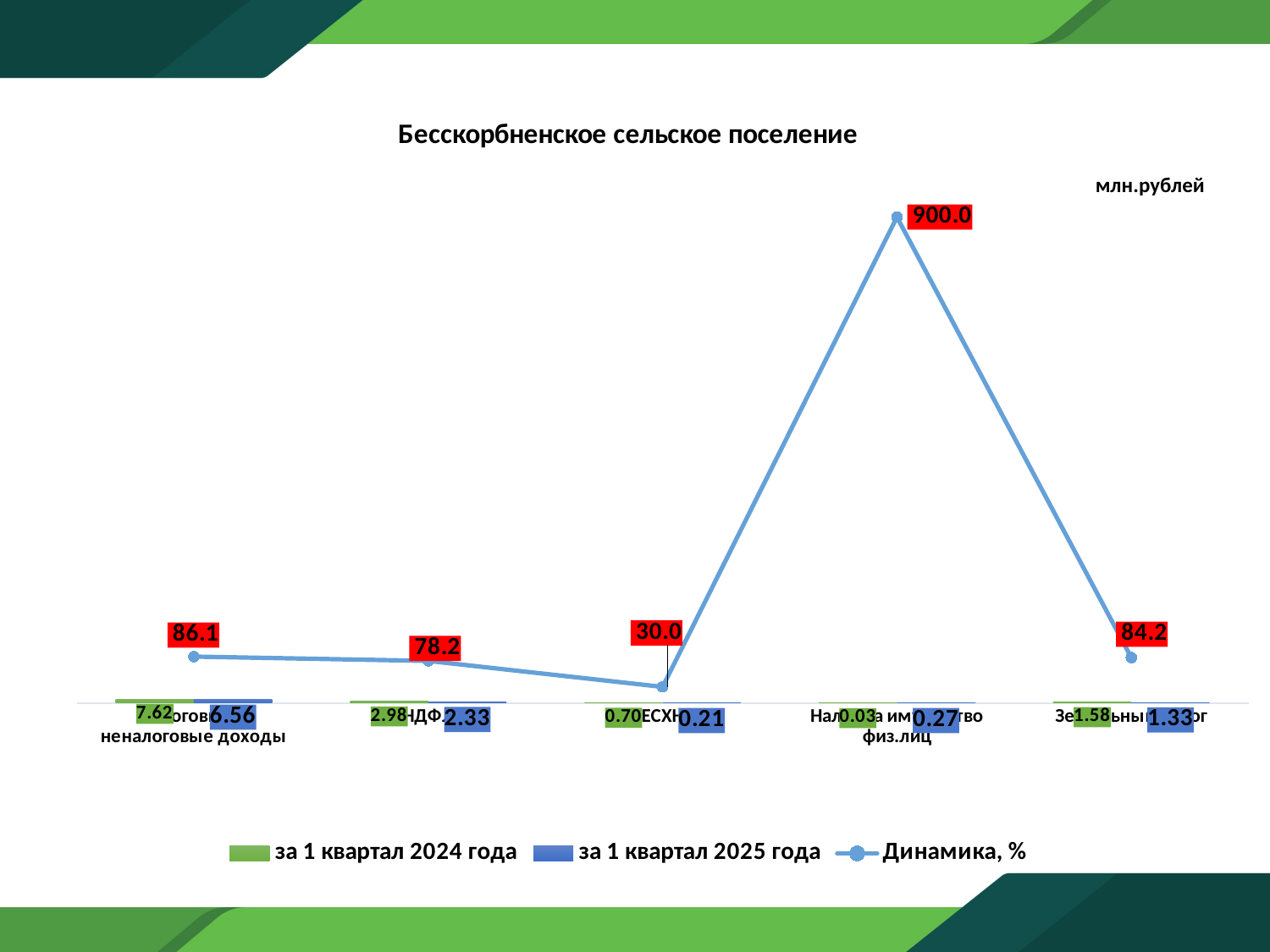
How many series does the legend list? 3 What is the value for ЕСХН за 1 квартал 2025 года? 0.21 Which category has the lowest value of Динамика, %? ЕСХН How many categories are shown on the x axis? 5 What is the title of the chart? Бесскорбненское сельское поселение Which category has the highest value of Динамика, %? Налог на имущество физ.лиц What is the difference between the 2024 and 2025 values for Земельный налог? 0.25 What is the value of Динамика, % for Налог на имущество физ.лиц? 900.0 What is the value for Земельный налог за 1 квартал 2025 года? 1.33 For Налог на имущество физ.лиц, which is larger: the value за 1 квартал 2024 года or за 1 квартал 2025 года? за 1 квартал 2025 года What is the value for ЕСХН за 1 квартал 2024 года? 0.70 What kind of chart is shown on the slide? A combined bar and line chart